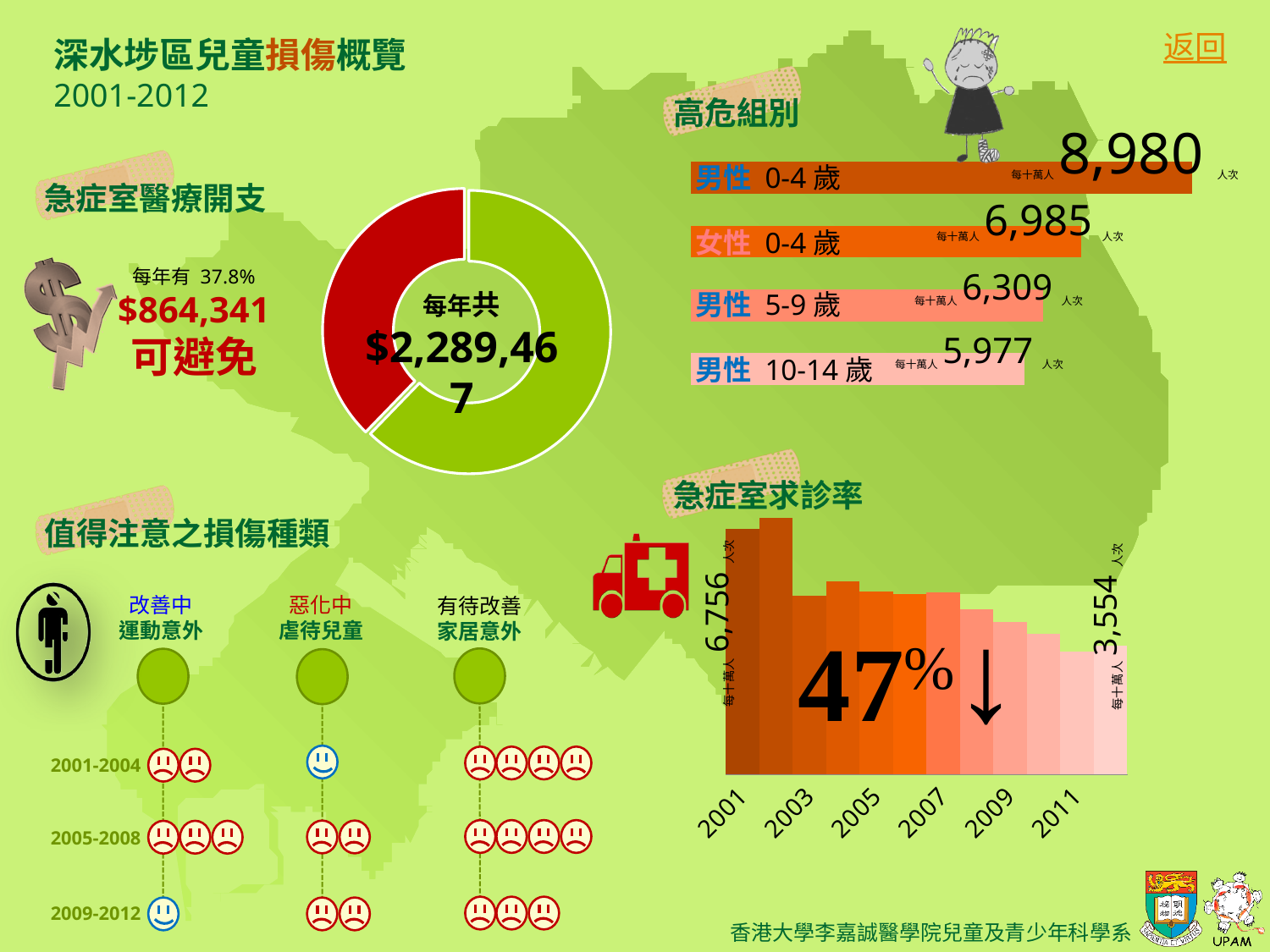
In the 高危組別 bar chart, what is the value for 女性 0-4 歲? 6,985 In the 急症室求診率 chart, what is the value for 2001? 6,756 In the 高危組別 bar chart, what is the value for 男性 0-4 歲? 8,980 In the 急症室求診率 chart, what is the difference between the 2001 value (6,756) and the final value (3,554)? 3,202 In the 高危組別 bar chart, how many groups are shown? 4 In the 高危組別 bar chart, which group has the highest value? 男性 0-4 歲 In the 急症室求診率 chart, do the values rise or fall from 2001 to 2012? fall In the 高危組別 bar chart, what is the difference between the values for 男性 0-4 歲 and 女性 0-4 歲? 1,995 In the 高危組別 bar chart, which group has the lowest value? 男性 10-14 歲 What kind of chart is the 高危組別 chart? bar chart In the 急症室醫療開支 donut chart, what is the total annual amount shown in the centre? $2,289,467 In the 急症室醫療開支 donut chart, what share of the annual spending is shown as avoidable (可避免)? 37.8%